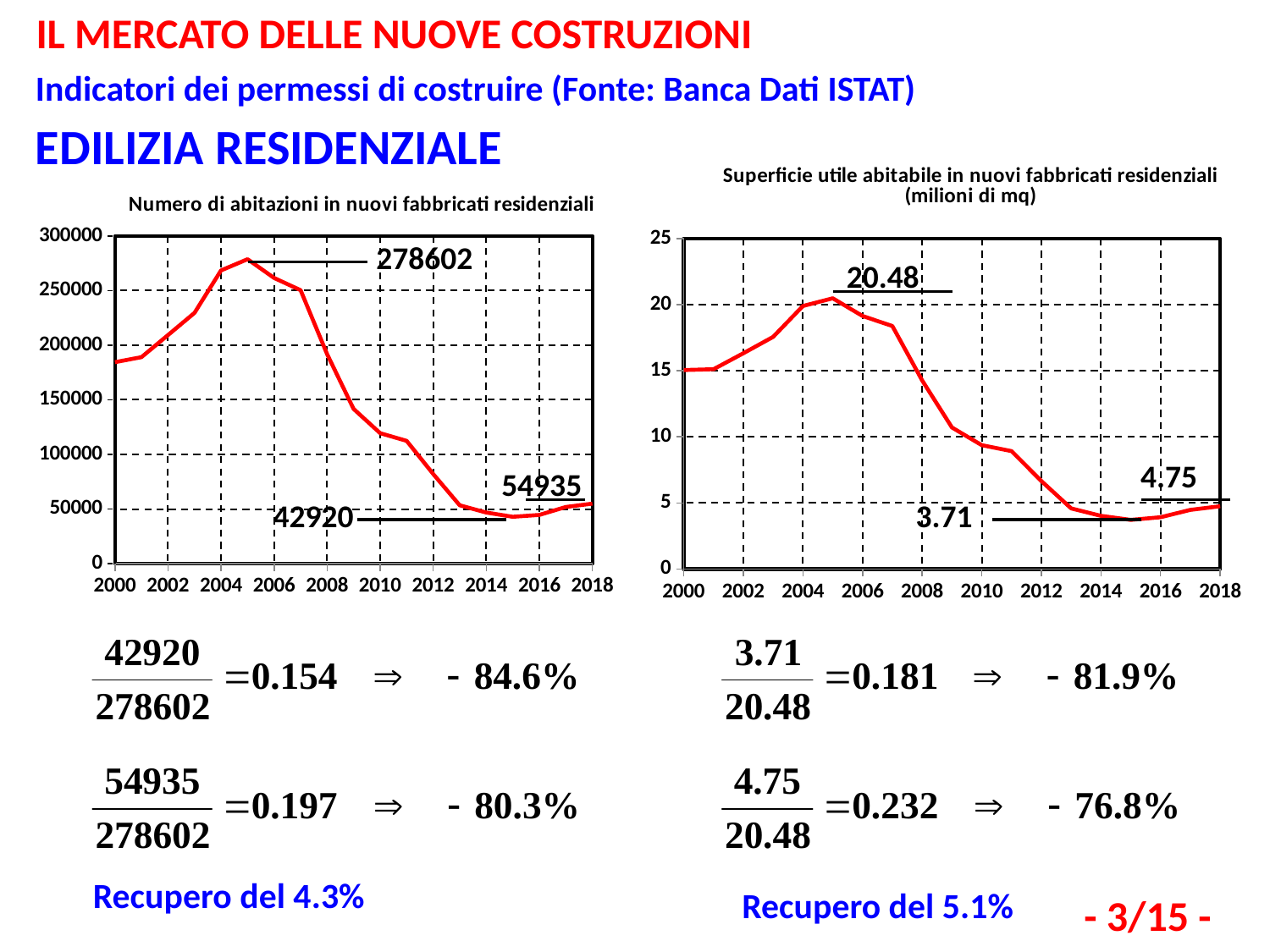
In the chart 'Superficie utile abitabile in nuovi fabbricati residenziali', what is the difference between the peak value 20.48 and the minimum value 3.71? 16.77 In the chart 'Numero di abitazioni in nuovi fabbricati residenziali', what value is labelled at the end of the series in 2018? 54935 In the chart 'Superficie utile abitabile in nuovi fabbricati residenziali', what value is labelled for 2018? 4.75 In the chart 'Superficie utile abitabile in nuovi fabbricati residenziali', what is the peak value labelled on the line? 20.48 In the chart 'Numero di abitazioni in nuovi fabbricati residenziali', what is the peak value labelled on the line? 278602 In the chart 'Numero di abitazioni in nuovi fabbricati residenziali', is the value for 2000 greater or less than 150000? greater In the chart 'Numero di abitazioni in nuovi fabbricati residenziali', what is the difference between the peak value 278602 and the minimum value 42920? 235682 In the chart 'Numero di abitazioni in nuovi fabbricati residenziali', what is the lowest value labelled on the line? 42920 In the chart 'Superficie utile abitabile in nuovi fabbricati residenziali', is the value for 2010 greater or less than 10? less In the chart 'Superficie utile abitabile in nuovi fabbricati residenziali', what is the lowest value labelled on the line? 3.71 What type of chart is 'Superficie utile abitabile in nuovi fabbricati residenziali'? line chart In the chart 'Numero di abitazioni in nuovi fabbricati residenziali', in which year does the line reach its maximum? 2005